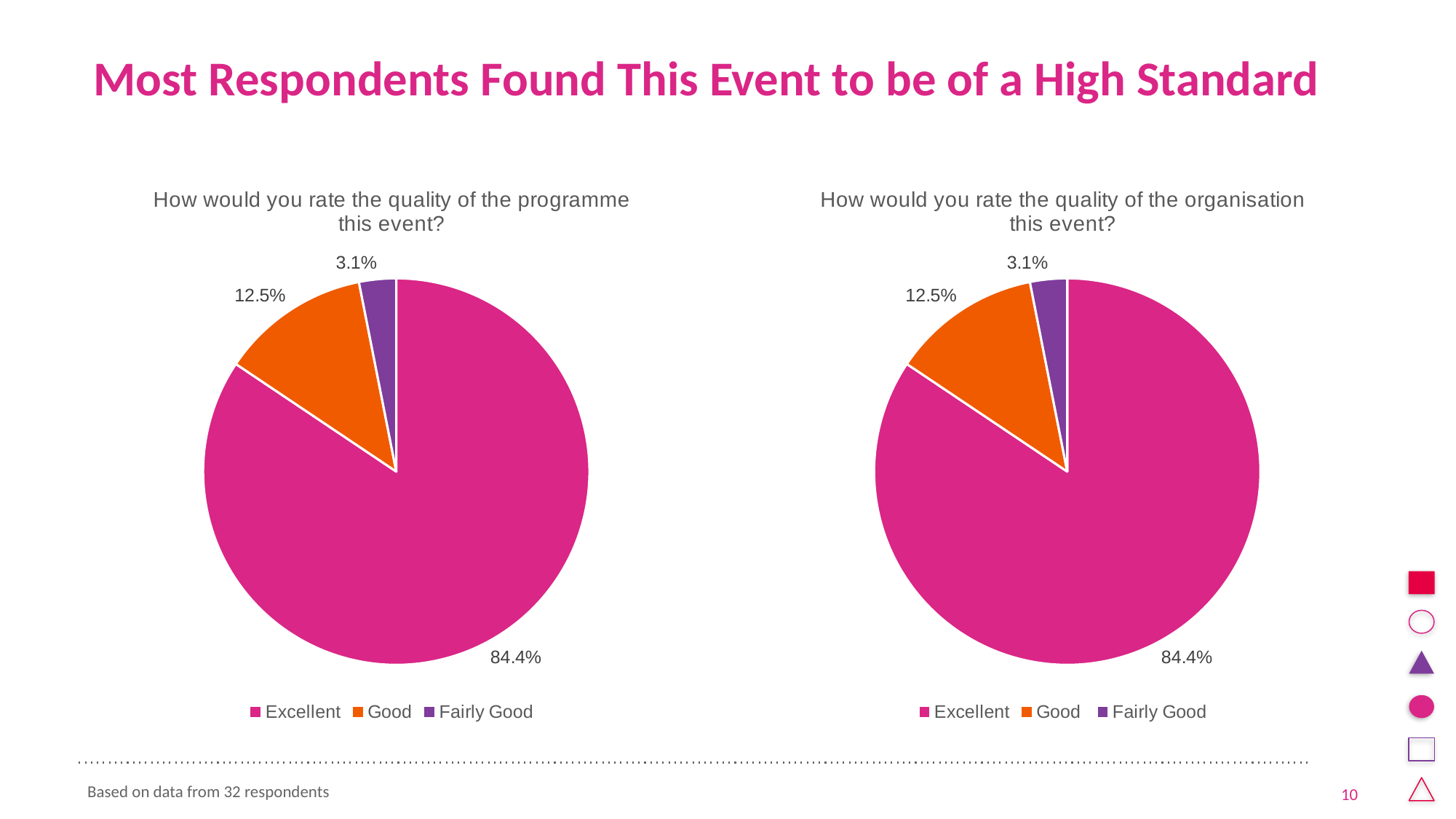
In the left chart (quality of the programme), what share of respondents rated it Good? 12.5% What type of chart is used on the left of the slide? Pie chart In the right chart (quality of the organisation), which is larger, the share for Good or the share for Fairly Good? Good How many entries does the legend of the right chart (quality of the organisation) list? 3 In the right chart (quality of the organisation), what colour is the Good slice? Orange In the left chart (quality of the programme), what share of respondents rated it Excellent? 84.4% How many slices does the left chart (quality of the programme) have? 3 In the right chart (quality of the organisation), which rating has the smallest share? Fairly Good In the left chart (quality of the programme), what is the difference between the Good and Fairly Good shares? 9.4% In the right chart (quality of the organisation), what share of respondents rated it Fairly Good? 3.1% In the right chart (quality of the organisation), what share of respondents rated it Excellent? 84.4% In the left chart (quality of the programme), which rating has the largest share? Excellent